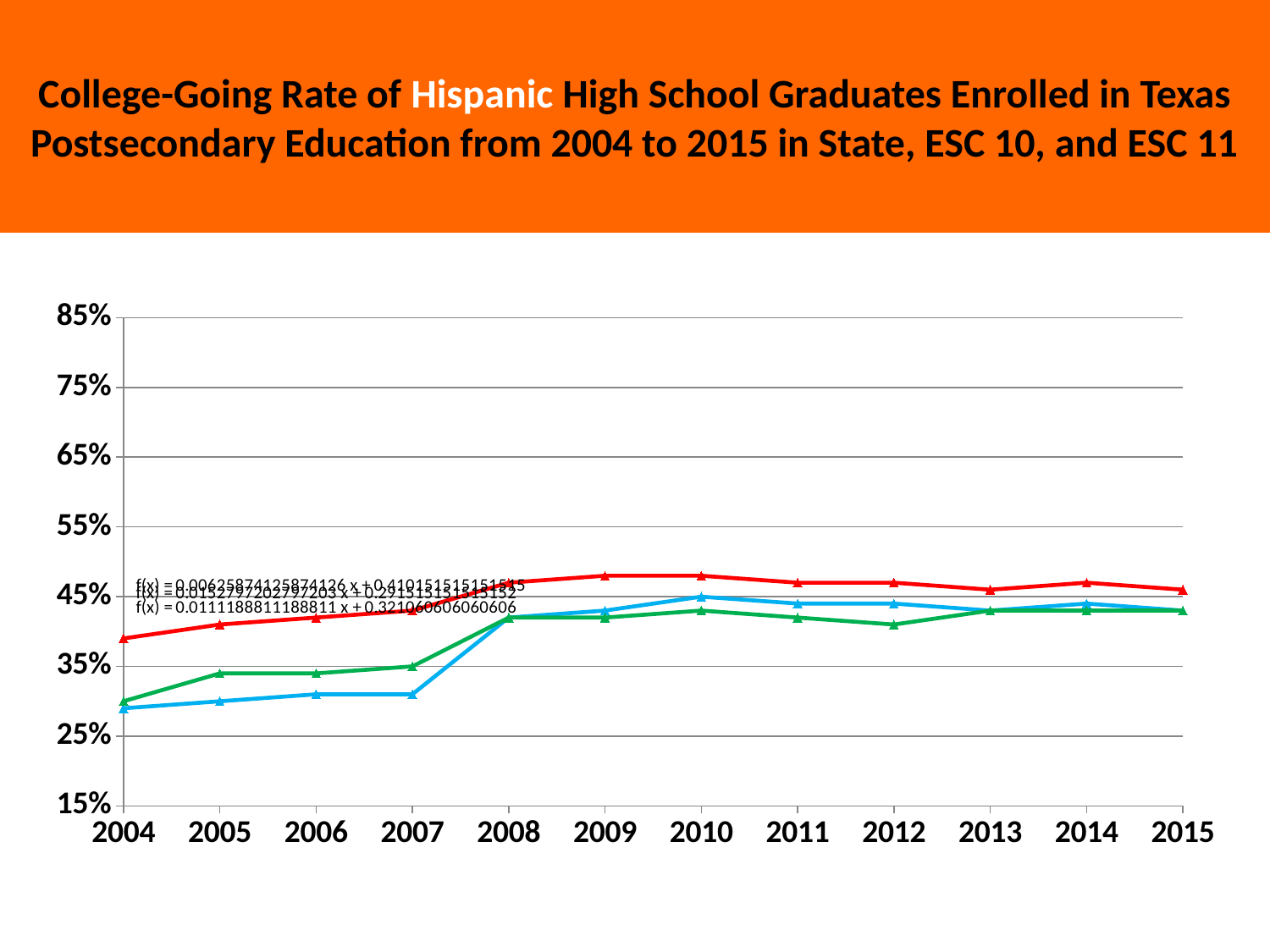
How many lines are plotted on the chart? 3 What range of years does the chart title say the data covers? 2004 to 2015 Is the value of the green line in 2007 greater or less than 45%? less What kind of chart is shown on the slide? line chart Does the red line rise or fall from 2004 to 2009? rise Is the value of the blue line in 2004 greater or less than 35%? less Is the value of the red line in 2009 greater or less than 45%? greater Which ethnic group of high school graduates does the chart title refer to? Hispanic In 2005, which line has the higher value, the blue line or the green line? green line How many years are plotted along the x axis of the chart? 12 In 2007, which line has the higher value, the red line or the green line? red line